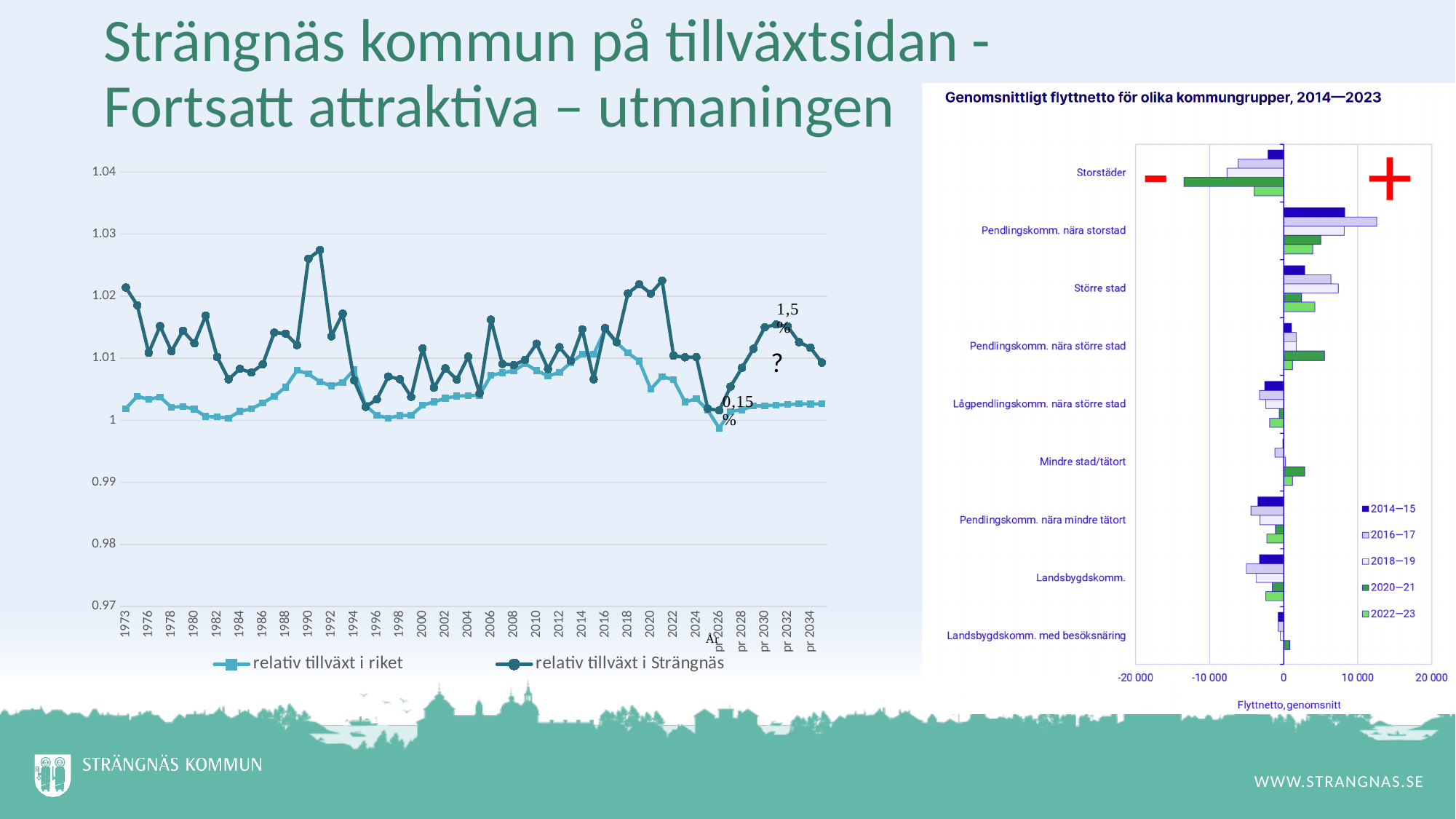
How many series does the legend of the right-hand chart 'Genomsnittligt flyttnetto för olika kommungrupper' list? 5 In the left-hand line chart, which series is higher in 1990, relativ tillväxt i riket or relativ tillväxt i Strängnäs? relativ tillväxt i Strängnäs What is the title of the right-hand chart? Genomsnittligt flyttnetto för olika kommungrupper, 2014—2023 What kind of chart is the left-hand chart showing relativ tillväxt i riket and relativ tillväxt i Strängnäs? Line chart In the left-hand line chart, is the value for relativ tillväxt i riket in 1982 greater or less than 1.01? less What kind of chart is the right-hand chart titled 'Genomsnittligt flyttnetto för olika kommungrupper, 2014—2023'? Bar chart In the right-hand chart 'Genomsnittligt flyttnetto för olika kommungrupper', which kommungrupp has the highest 2016—17 value? Pendlingskomm. nära storstad How many series does the legend of the left-hand line chart list? 2 In the left-hand line chart, is the value for relativ tillväxt i Strängnäs in 1991 greater or less than 1.02? greater In the right-hand chart 'Genomsnittligt flyttnetto för olika kommungrupper', which kommungrupp has the lowest (most negative) 2020—21 value? Storstäder How many kommungrupper (categories) are shown in the right-hand chart 'Genomsnittligt flyttnetto för olika kommungrupper'? 9 In the right-hand chart 'Genomsnittligt flyttnetto för olika kommungrupper', is the 2016—17 value for Pendlingskomm. nära storstad greater or less than 10 000? greater